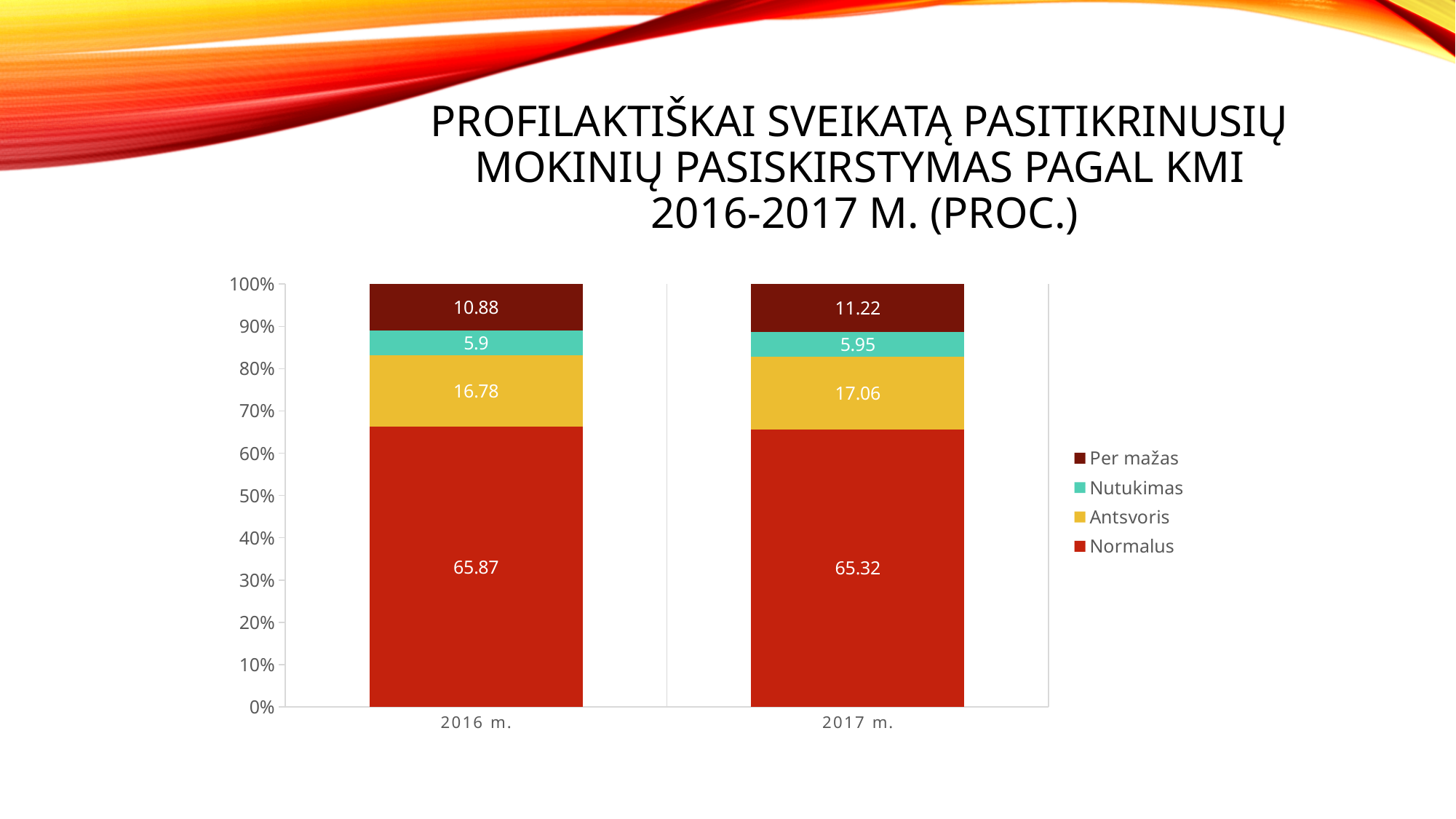
How many categories (years) are shown on the x axis? 2 Which year has the larger Antsvoris value, 2016 m. or 2017 m.? 2017 m. What is the value of the Antsvoris segment for 2017 m.? 17.06 What is the difference between the Per mažas values for 2017 m. and 2016 m.? 0.34 What kind of chart is shown on the slide? Stacked bar chart What is the value of the Nutukimas segment for 2016 m.? 5.9 What is the value of the Per mažas segment for 2017 m.? 11.22 What is the value of the Normalus segment for 2016 m.? 65.87 What is the difference between the Normalus values for 2016 m. and 2017 m.? 0.55 Which series has the largest segment in the 2016 m. bar? Normalus How many series does the legend list? 4 Which series has the smallest segment in the 2017 m. bar? Nutukimas